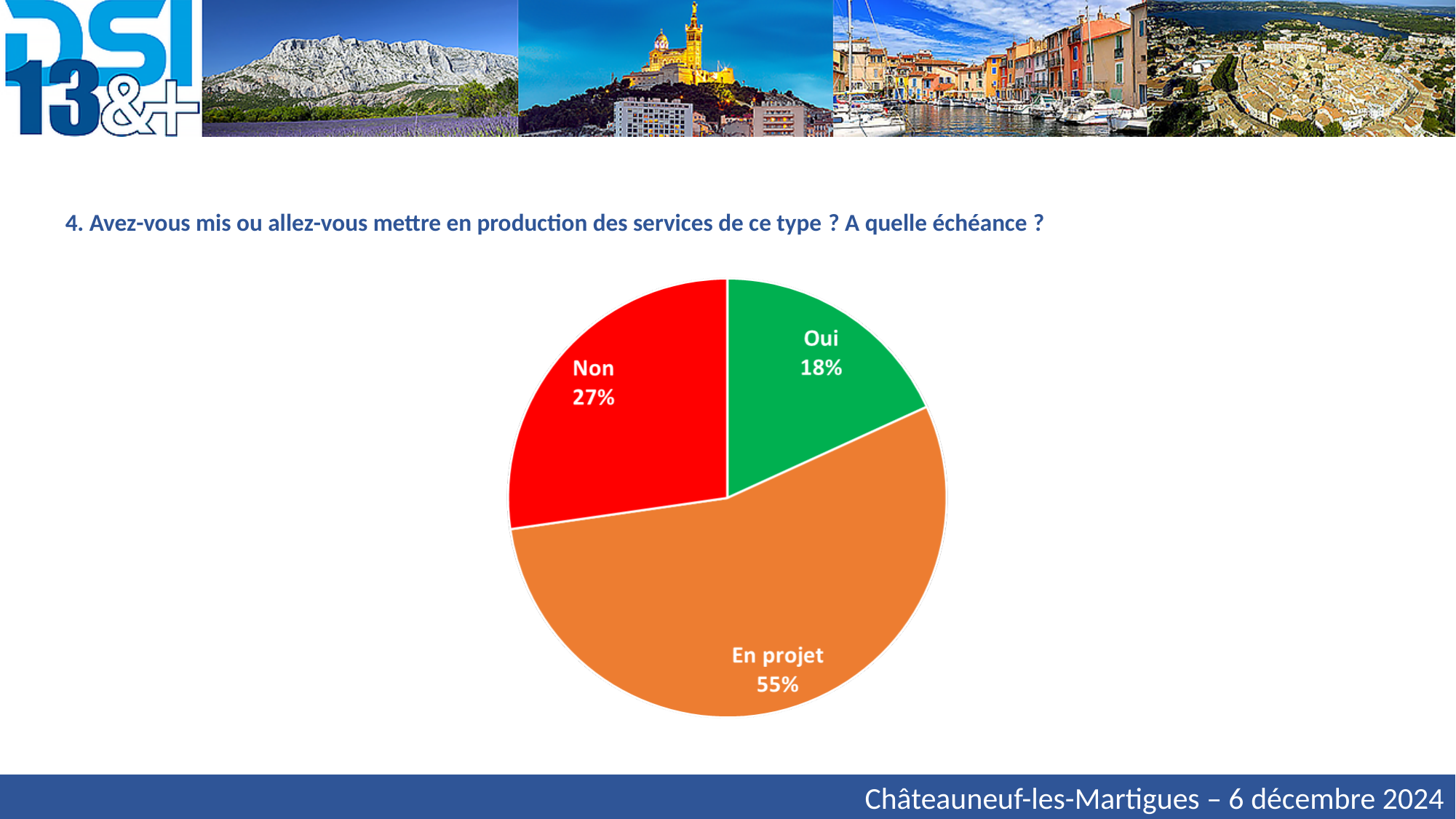
What share of the pie does "En projet" represent? 55% What is the difference between the "En projet" and "Non" shares? 28% How many slices does the pie chart have? 3 What kind of chart is shown on the slide? pie chart Which category has the largest slice of the pie? En projet What is the value shown for "Oui"? 18% What colour is the "En projet" slice? orange What is the difference between the "Non" and "Oui" shares? 9% Which is larger, the share for "Non" or the share for "Oui"? Non What is the value shown for "Non"? 27% Which category has the smallest slice of the pie? Oui What colour is the "Non" slice? red